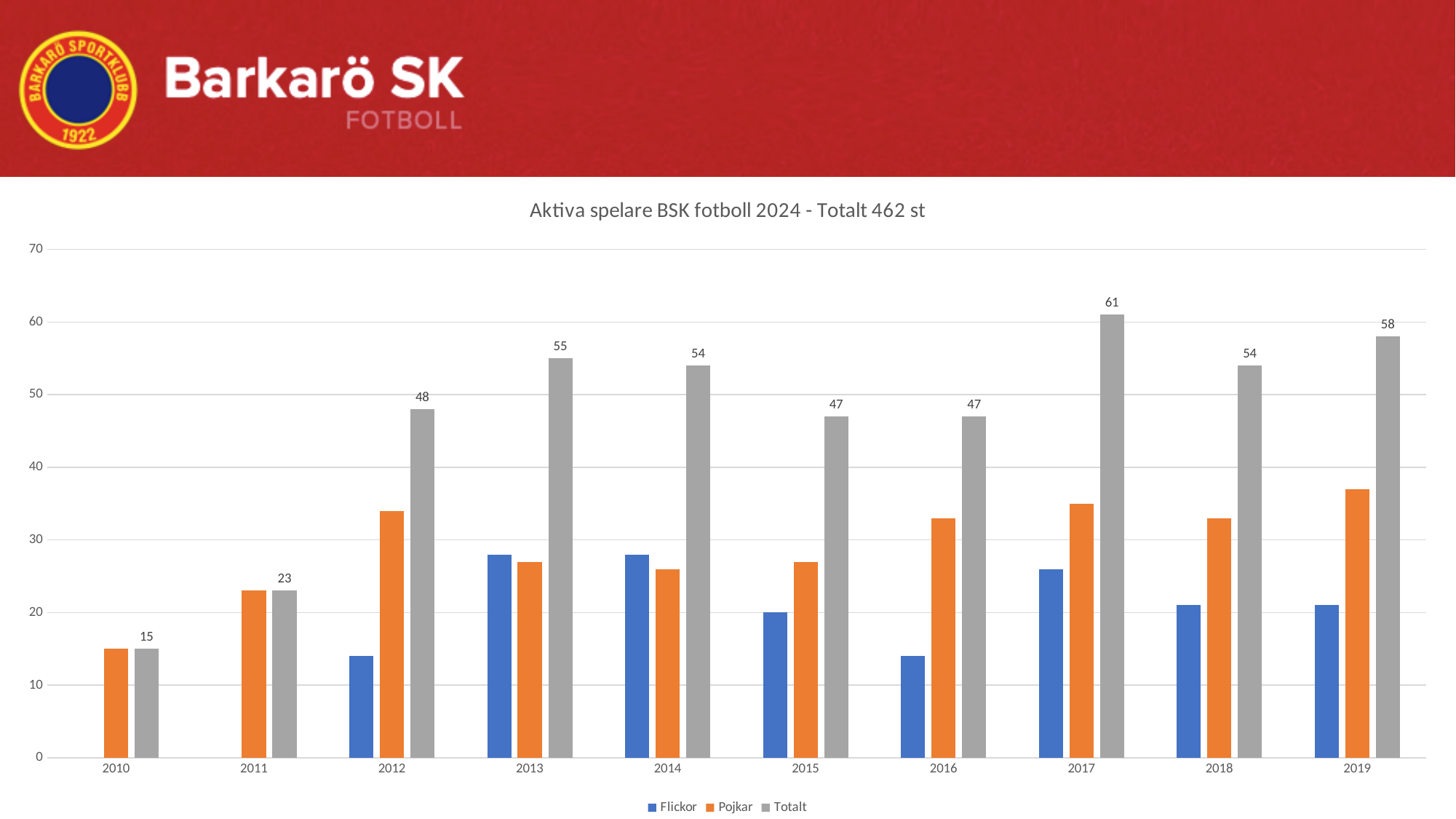
Is the Pojkar value for 2019 greater or less than 30? greater What is the title of the chart? Aktiva spelare BSK fotboll 2024 - Totalt 462 st Which year has the highest Totalt value? 2017 How many series does the legend list? 3 What kind of chart is shown on the slide? Bar chart What is the Totalt value for 2017? 61 Which year has the larger Totalt value, 2013 or 2014? 2013 How many years are shown on the x axis? 10 What is the difference between the Totalt values for 2017 and 2010? 46 What is the Totalt value for 2012? 48 Is the Flickor value for 2012 greater or less than 20? less Which year has the lowest Totalt value? 2010